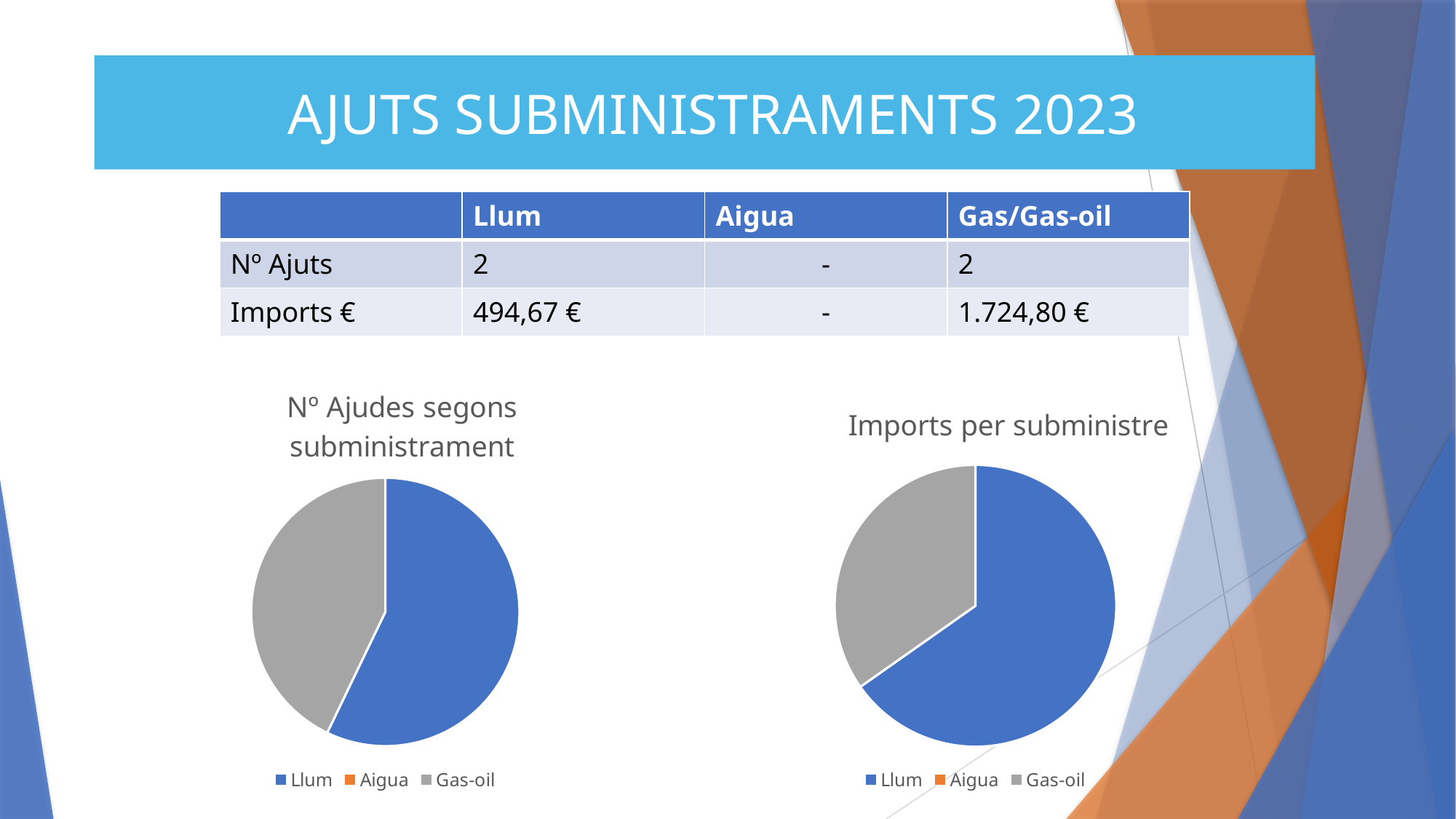
In the 'Nº Ajudes segons subministrament' chart, which category has the largest slice? Llum How many entries does the legend of the 'Imports per subministre' chart list? 3 In the pie charts, what colour represents Gas-oil? grey In the 'Nº Ajudes segons subministrament' chart, which slice is larger, Llum or Gas-oil? Llum In the 'Imports per subministre' chart, which category has the largest slice? Llum What kind of chart is the 'Imports per subministre' chart on the right? pie chart In the 'Imports per subministre' chart, which slice is larger, Llum or Gas-oil? Llum How many entries does the legend of the 'Nº Ajudes segons subministrament' chart list? 3 What is the title of the pie chart on the right of the slide? Imports per subministre How many slices are visible in the 'Imports per subministre' pie chart? 2 What kind of chart is the 'Nº Ajudes segons subministrament' chart on the left? pie chart